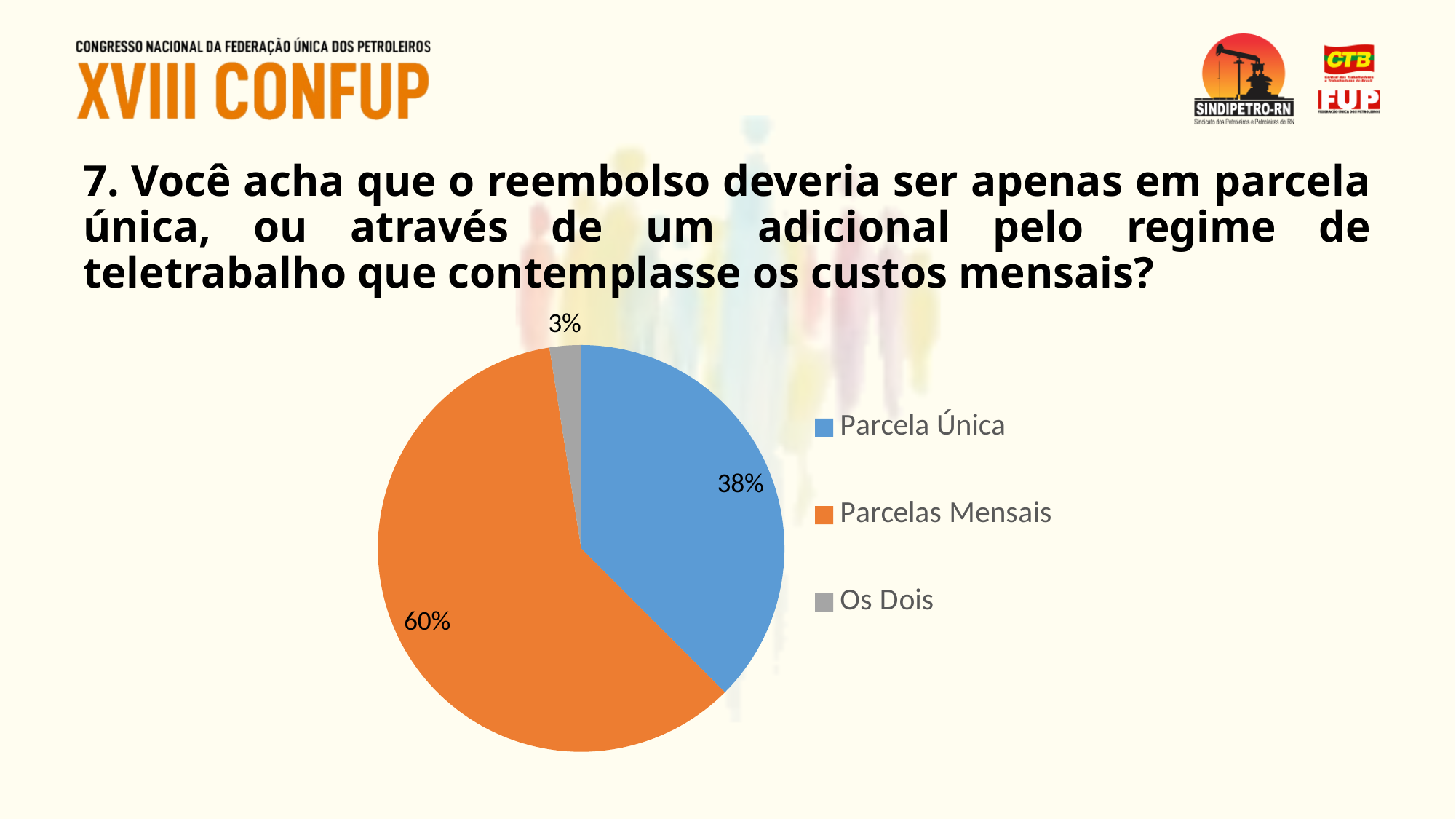
What share of the pie does Parcelas Mensais represent? 60% Which category has the largest slice of the pie? Parcelas Mensais What share of the pie does Parcela Única represent? 38% Which legend entry is shown in grey? Os Dois What share of the pie does Os Dois represent? 3% What colour is the slice for Parcelas Mensais? orange How many categories does the pie chart have? 3 What is the difference in percentage points between Parcela Única and Os Dois? 35 Which is larger, the slice for Parcela Única or the slice for Parcelas Mensais? Parcelas Mensais What kind of chart is shown on the slide? pie chart Which category has the smallest slice of the pie? Os Dois What is the difference in percentage points between Parcelas Mensais and Parcela Única? 22